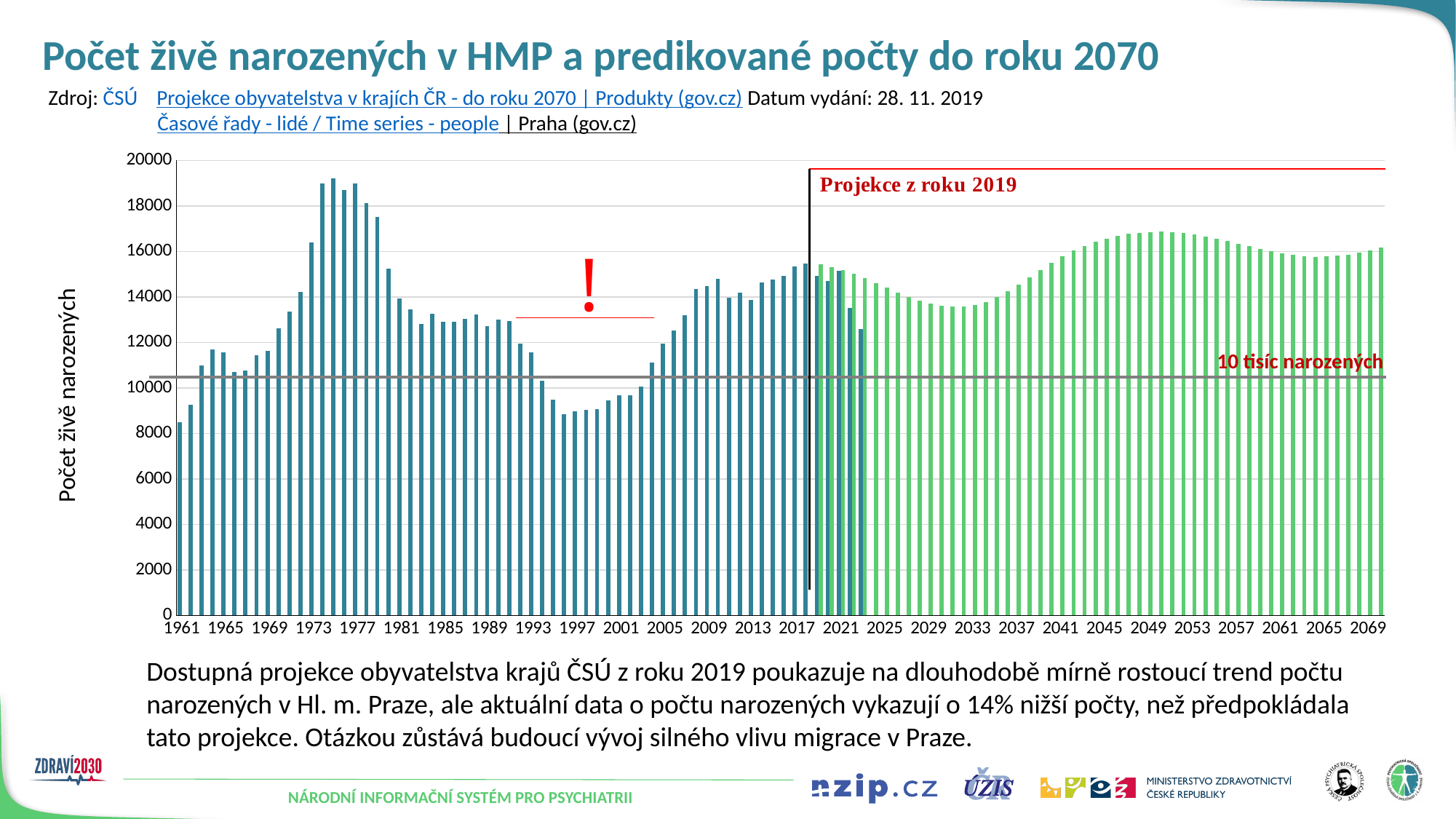
Is the value for 1961 greater or less than 10000? less Which year has the larger value, 1977 or 1997? 1977 Is the value for 1977 greater or less than 18000? greater Is the value for 2017 greater or less than 14000? greater What kind of chart is shown on the slide? bar chart Do the values rise or fall between 1977 and 1997? fall Which year has the larger value, 2033 or 2049? 2049 What label is written next to the horizontal reference line on the chart? 10 tisíc narozených What is the label of the vertical axis? Počet živě narozených